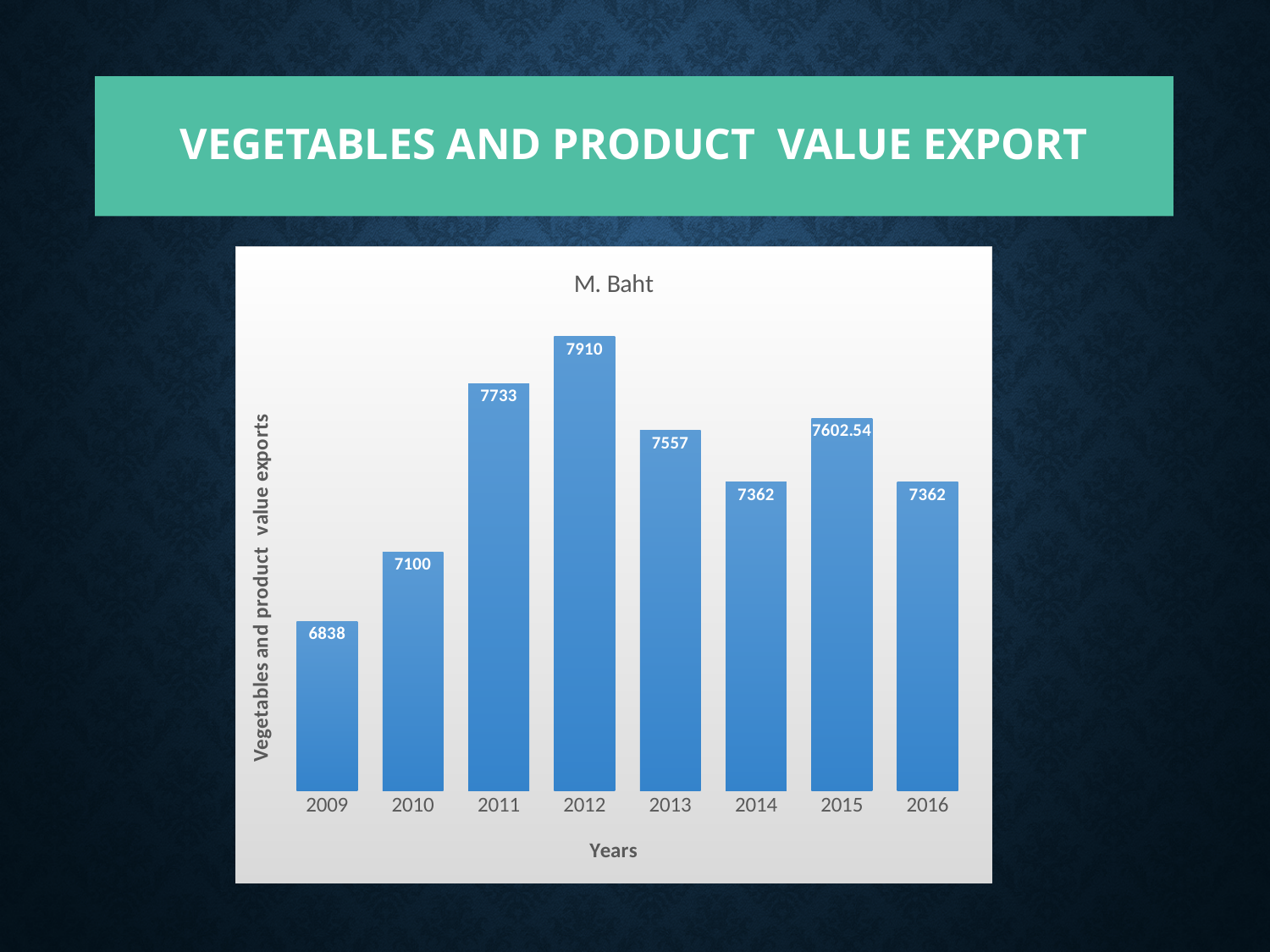
What is the difference between the values for 2012 and 2009? 1072 What is the title shown above the chart's plot area? M. Baht What is the value for 2015? 7602.54 What kind of chart is shown on the slide? Bar chart Which year has the lowest value? 2009 What is the difference between the values for 2011 and 2010? 633 What is the value for 2009? 6838 Do the values rise or fall from 2009 to 2012? Rise Which is larger, the value for 2013 or the value for 2014? 2013 Which year has the highest value? 2012 What is the value for 2012? 7910 How many years are shown on the x axis? 8